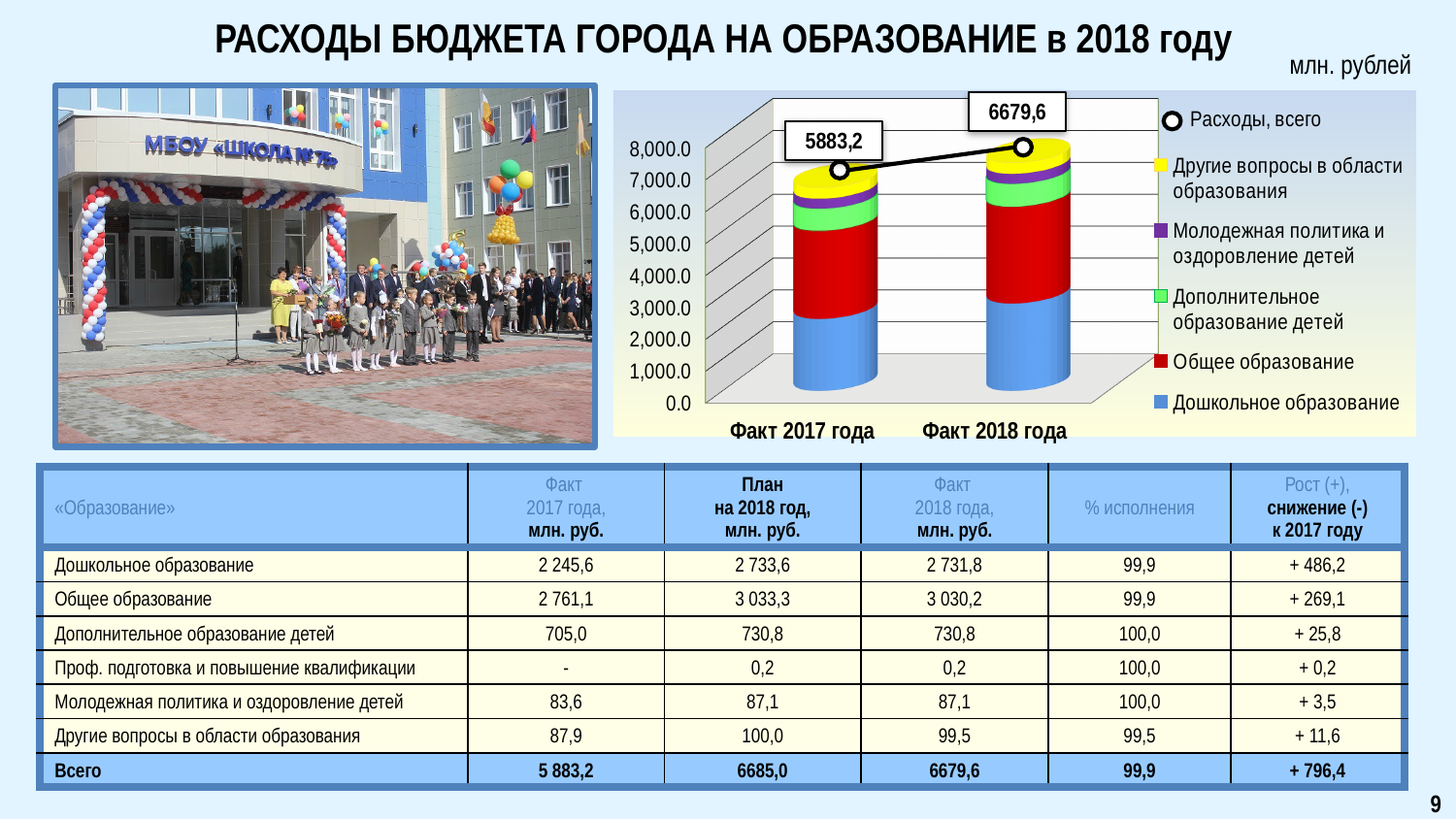
What unit is indicated above the chart? млн. рублей What is the value of the 'Расходы, всего' data label for 'Факт 2017 года'? 5883,2 Is the 'Дошкольное образование' segment for 'Факт 2017 года' greater or less than 3,000.0? less Which series is shown in red in the chart legend? Общее образование What is the value of the 'Расходы, всего' data label for 'Факт 2018 года'? 6679,6 How many categories are shown on the x axis of the chart? 2 How many series does the chart legend list? 6 Which category has the higher 'Расходы, всего' value, 'Факт 2017 года' or 'Факт 2018 года'? Факт 2018 года What is the difference between the 'Расходы, всего' values for 'Факт 2018 года' and 'Факт 2017 года'? 796,4 Does the 'Расходы, всего' line rise or fall from 'Факт 2017 года' to 'Факт 2018 года'? Rises Is the total stacked bar for 'Факт 2018 года' greater or less than 6,000.0? greater What kind of chart is shown on the slide? Stacked bar chart with a line